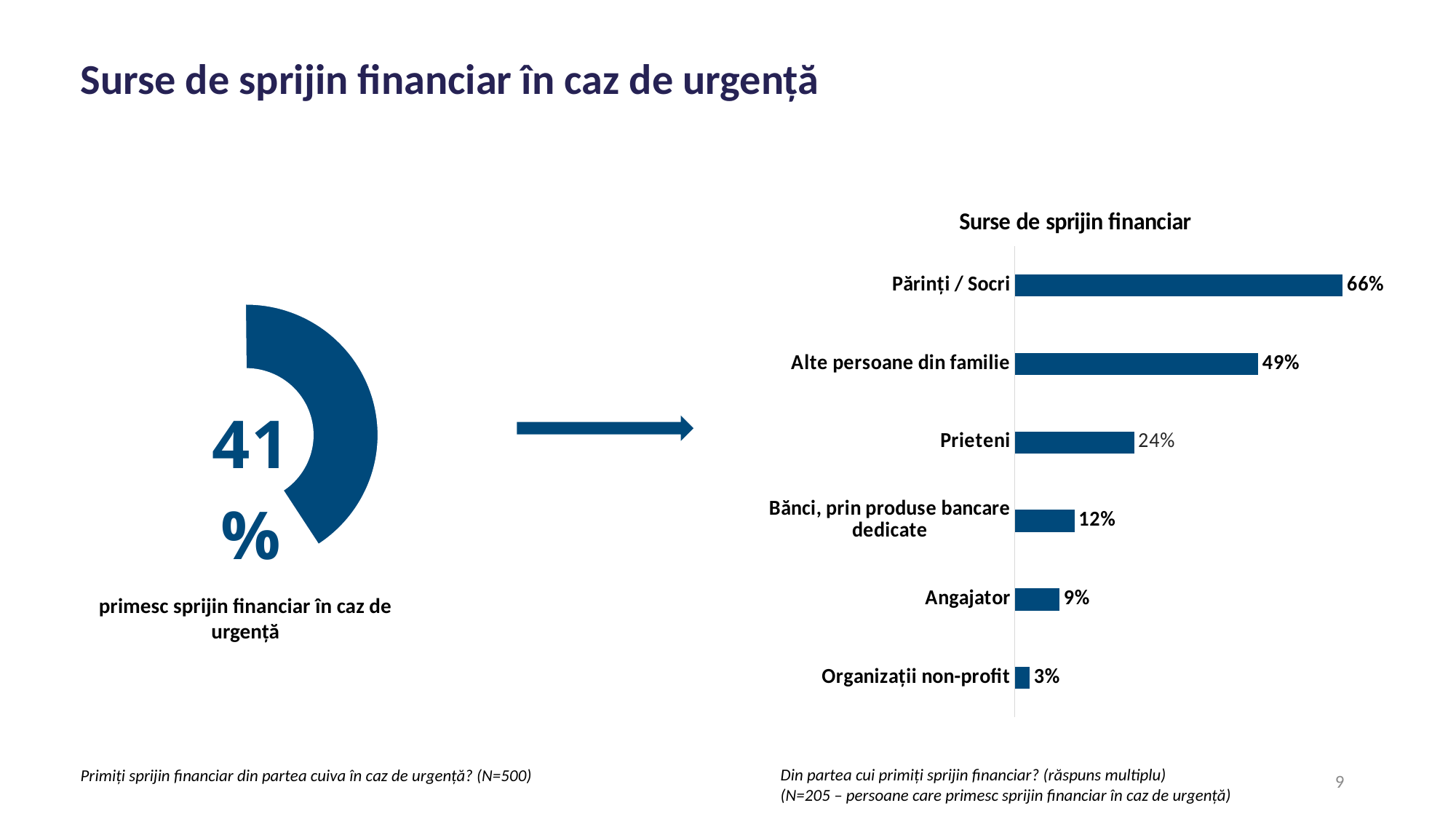
What is the title of the bar chart on the right of the slide? Surse de sprijin financiar In the 'Surse de sprijin financiar' bar chart, what is the value for Prieteni? 24% In the 'Surse de sprijin financiar' bar chart, which category has the highest value? Părinți / Socri In the 'Surse de sprijin financiar' bar chart, what is the value for Părinți / Socri? 66% What percentage is shown in the donut chart on the left of the slide? 41% What kind of chart is the 'Surse de sprijin financiar' chart on the right? Bar chart In the 'Surse de sprijin financiar' bar chart, what is the difference between Părinți / Socri and Alte persoane din familie? 17% In the 'Surse de sprijin financiar' bar chart, which category has the lowest value? Organizații non-profit How many categories does the 'Surse de sprijin financiar' bar chart show? 6 In the 'Surse de sprijin financiar' bar chart, what is the value for Angajator? 9% In the 'Surse de sprijin financiar' bar chart, which is larger: Prieteni or Angajator? Prieteni In the 'Surse de sprijin financiar' bar chart, what is the value for Bănci, prin produse bancare dedicate? 12%